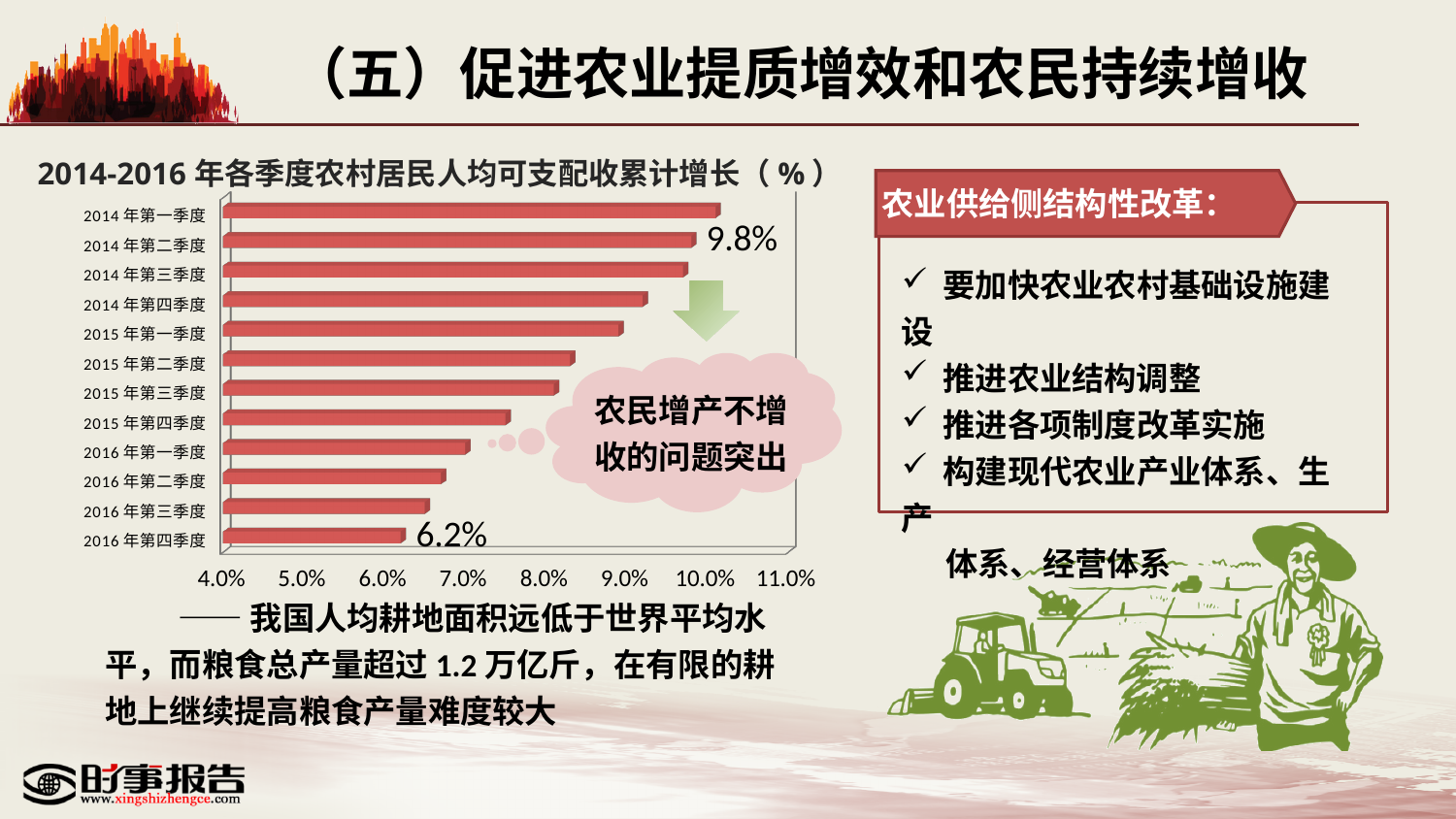
Is the value for 2015年第二季度 greater or less than 8.0%? greater What is the value for 2014年第二季度 in the chart? 9.8% What kind of chart is shown on the slide? Bar chart How many quarters are shown in the chart? 12 What is the difference between the values for 2014年第二季度 and 2016年第四季度? 3.6 percentage points Which is larger, the value for 2015年第一季度 or the value for 2016年第一季度? 2015年第一季度 Is the value for 2016年第三季度 greater or less than 7.0%? less Which quarter has the highest value in the chart? 2014年第一季度 Which quarter has the lowest value in the chart? 2016年第四季度 Do the values rise or fall from 2014年第一季度 to 2016年第四季度? Fall What is the value for 2016年第四季度 in the chart? 6.2%